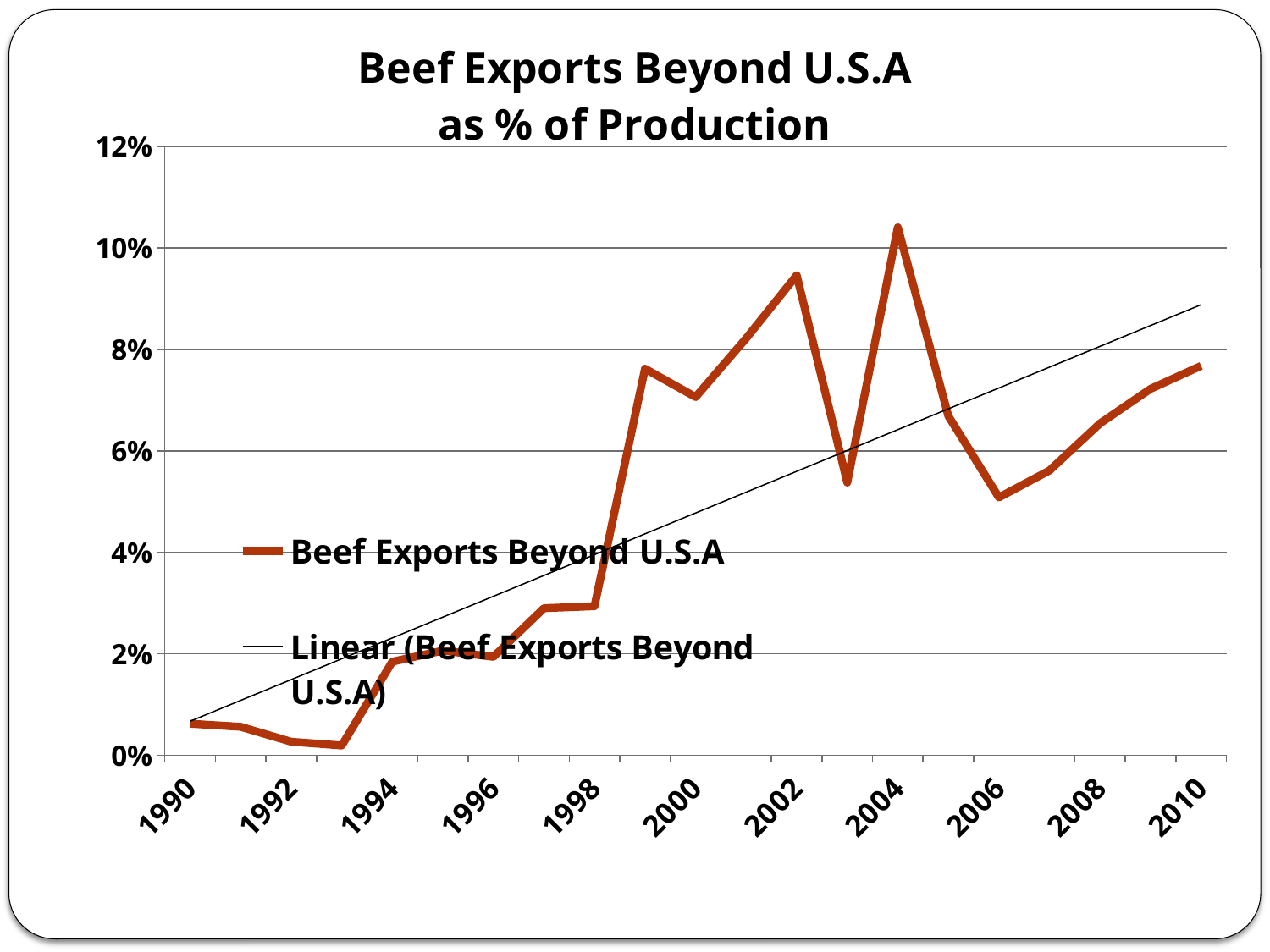
Is the value for Beef Exports Beyond U.S.A in 2006 greater or less than 6%? less In which year does the Beef Exports Beyond U.S.A line reach its highest value? 2004 Which year has the larger value for Beef Exports Beyond U.S.A, 2000 or 2002? 2002 Is the value for Beef Exports Beyond U.S.A in 2002 greater or less than 8%? greater What is the title of the chart? Beef Exports Beyond U.S.A as % of Production Overall, does the Beef Exports Beyond U.S.A line rise or fall from 1990 to 2010? rise How many year labels are shown on the x axis? 11 Is the value for Beef Exports Beyond U.S.A in 2004 greater or less than 10%? greater How many entries does the legend list? 2 Which year has the larger value for Beef Exports Beyond U.S.A, 1998 or 2000? 2000 What kind of chart is shown on the slide? line chart